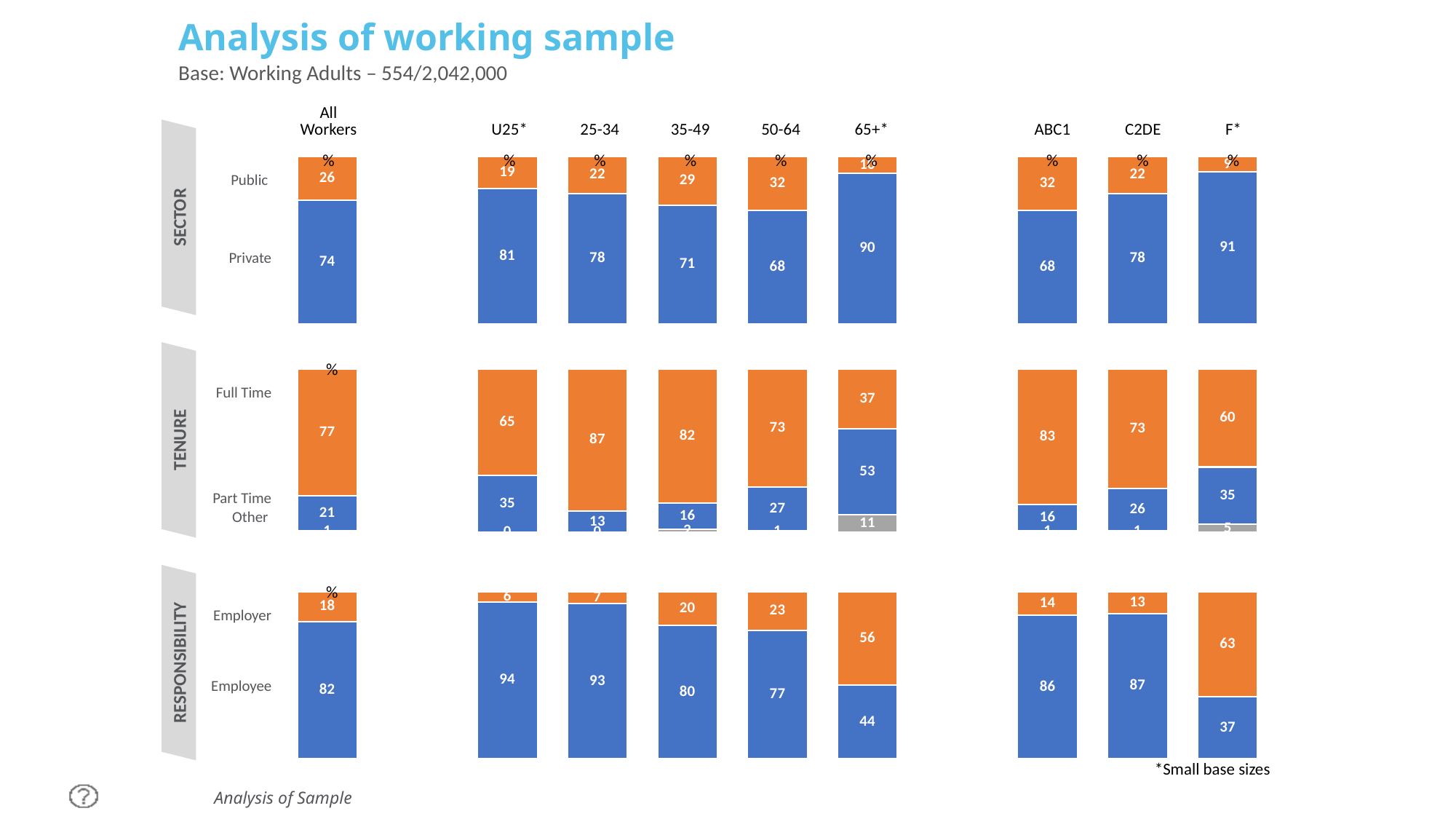
In the Responsibility chart, what is the Employer value for the F* group? 63 In the Sector chart, what is the Public value for the 50-64 group? 32 In the Responsibility chart, which group has the highest Employee value? U25* In the Tenure chart, what is the Other value for the 65+* group? 11 How many groups (bars) are shown in the Responsibility chart? 9 In the Tenure chart, which group has the lowest Full Time value? 65+* In the Responsibility chart, which is larger: the Employer value for 35-49 or for 50-64? 50-64 In the Sector chart, what is the Private value for All Workers? 74 In the Tenure chart, what is the Part Time value for the 65+* group? 53 In the Tenure chart, what is the Full Time value for the 25-34 group? 87 What type of chart is used in the Sector row? Stacked bar chart In the Sector chart, what is the difference between the Private values for U25* and 50-64? 13